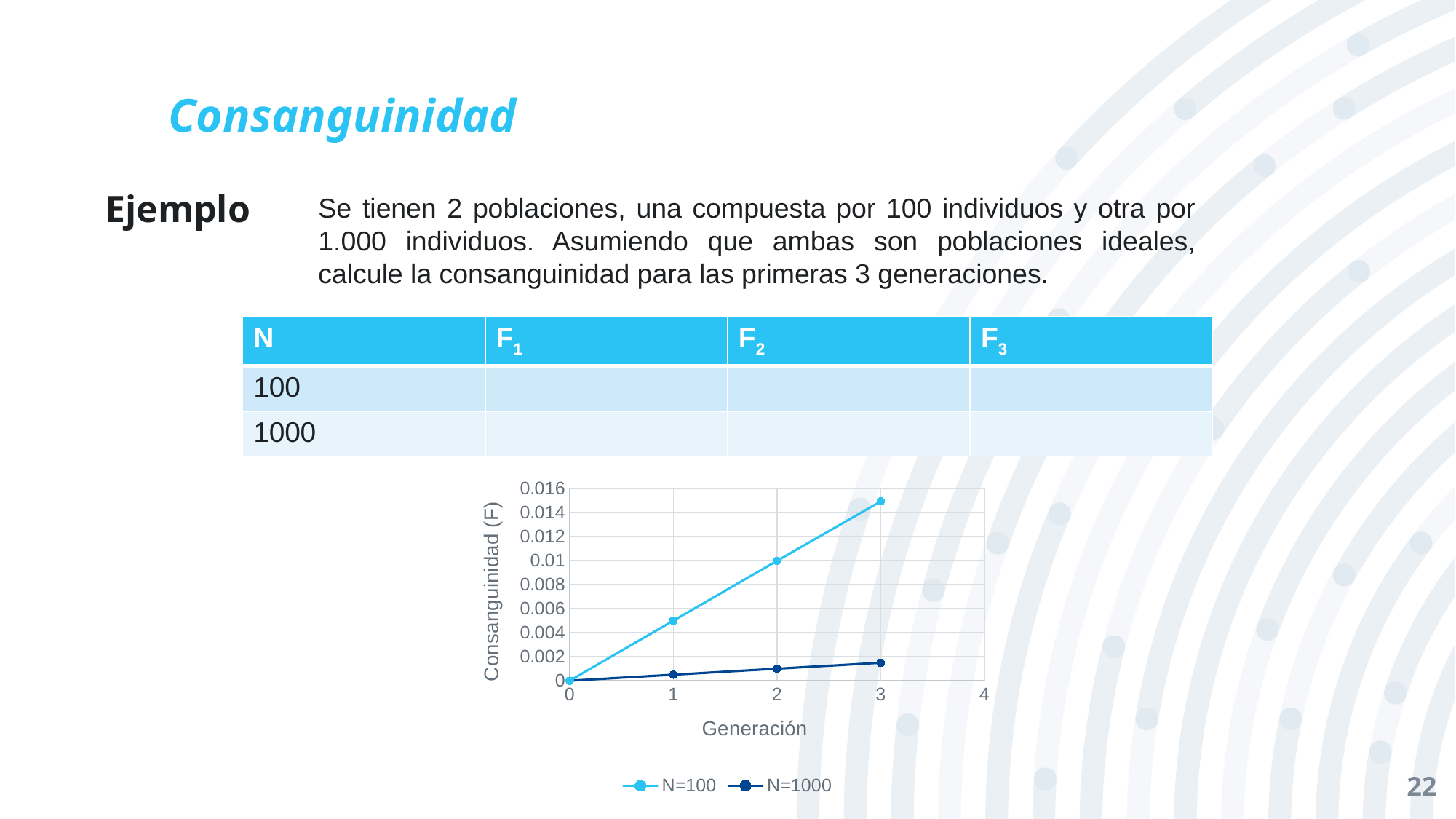
How many series does the chart legend list? 2 Is the value for N=100 at generation 1 greater or less than 0.006? less What is the title of the y axis of the chart? Consanguinidad (F) Do the values of the N=100 series rise or fall as the generation increases? rise How many data points are plotted for the N=100 series? 4 What is the value of the N=100 series at generation 2? 0.01 What are the two series named in the chart legend? N=100 and N=1000 Is the value for N=1000 at generation 3 greater or less than 0.002? less What kind of chart is shown on the slide? line chart At generation 3, which series has the larger value, N=100 or N=1000? N=100 What is the value of the N=100 series at generation 0? 0 Is the value for N=100 at generation 3 greater or less than 0.014? greater